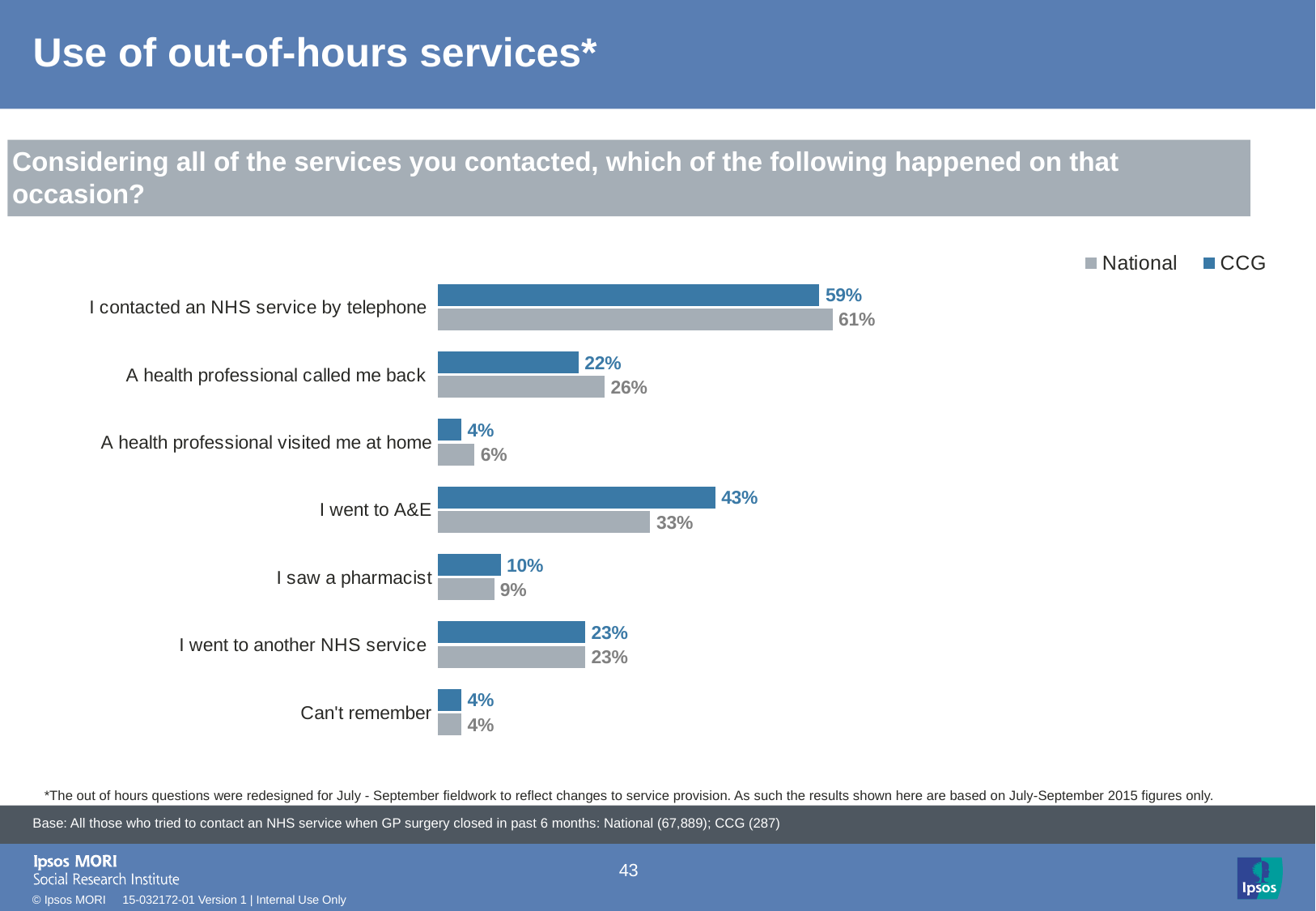
Which colour represents the CCG series in the chart? Blue What is the National value for "I saw a pharmacist"? 9% Which category has the lowest National value? Can't remember What is the difference between the CCG and National values for "I went to A&E"? 10% How many categories are shown in the chart? 7 How many series does the legend list? 2 What kind of chart is shown on the slide? Bar chart What is the National value for "A health professional called me back"? 26% Which is larger for "A health professional called me back": the CCG value or the National value? National Which category has the highest CCG value? I contacted an NHS service by telephone What is the CCG value for "I contacted an NHS service by telephone"? 59% What is the CCG value for "I went to A&E"? 43%